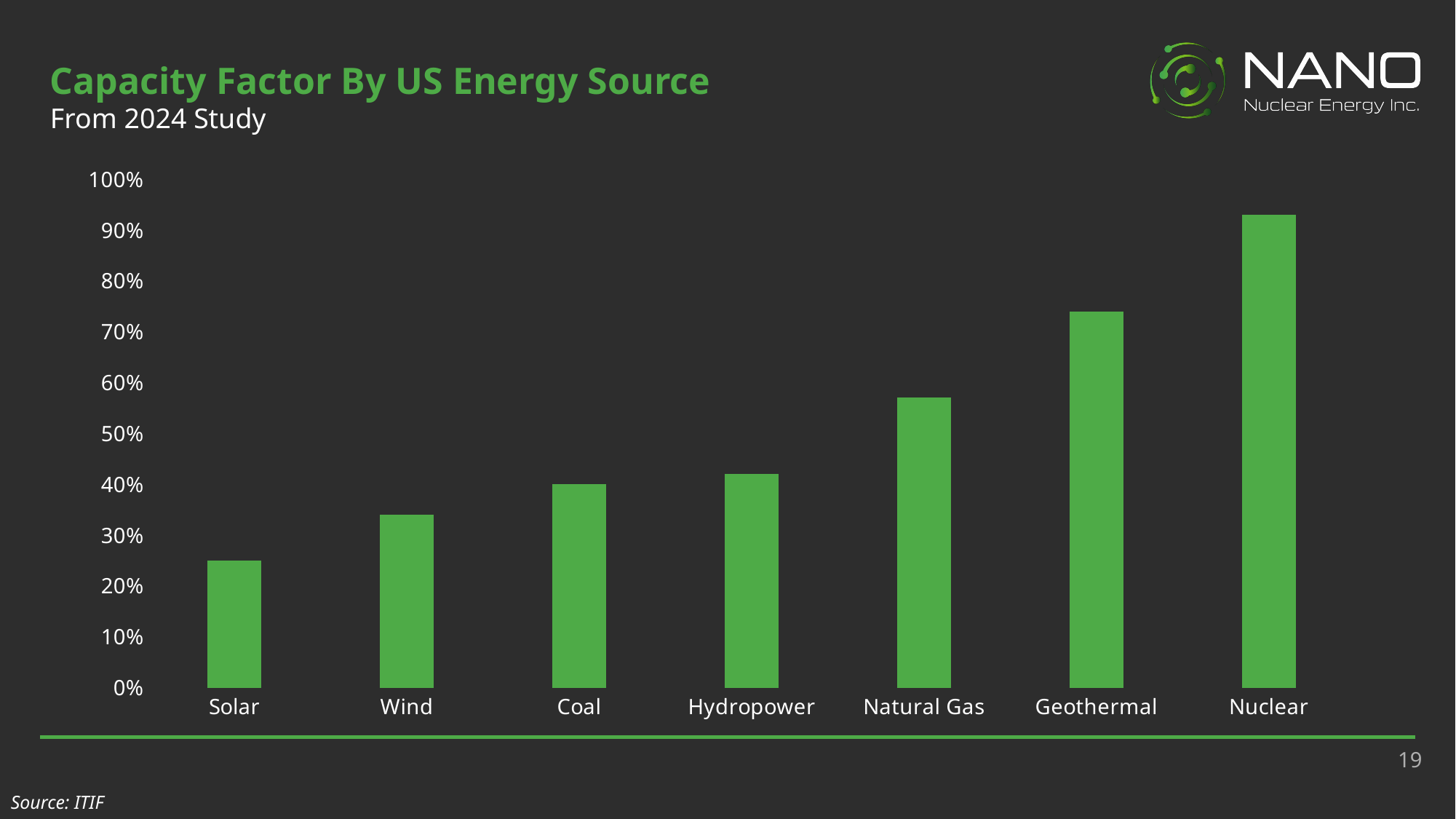
Which has a higher capacity factor, Geothermal or Natural Gas? Geothermal What kind of chart is shown on the slide? bar chart Which energy source has the highest capacity factor? Nuclear Do the capacity factors rise or fall moving from Solar to Nuclear along the x axis? rise Is the capacity factor for Natural Gas greater or less than 60%? less Is the capacity factor for Nuclear greater or less than 90%? greater How many energy sources are shown on the chart? 7 Is the capacity factor for Wind greater or less than 30%? greater What is the title of the chart? Capacity Factor By US Energy Source Which energy source has the lowest capacity factor? Solar